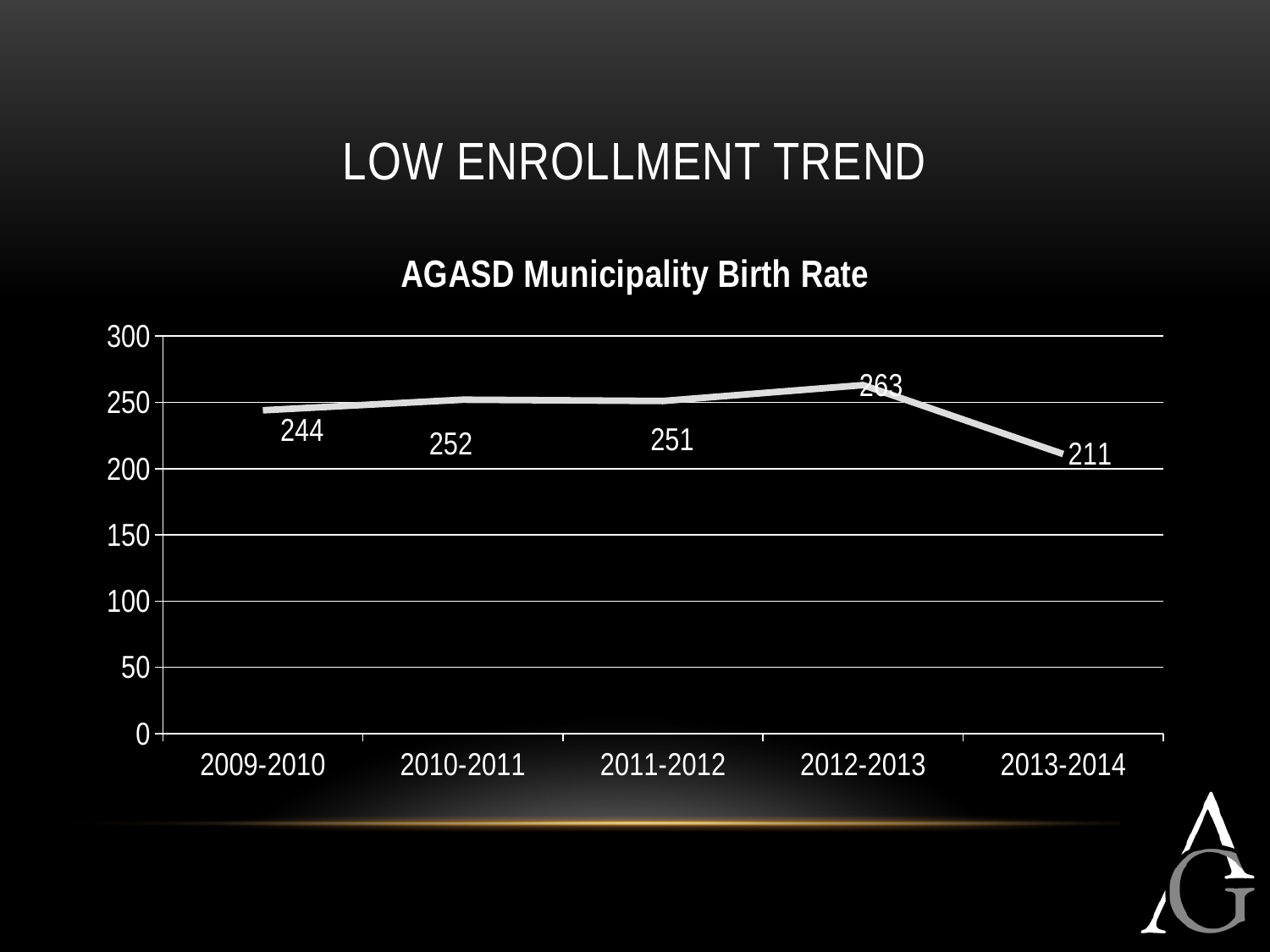
Which is larger, the birth rate in 2010-2011 or in 2011-2012? 2010-2011 What is the birth rate value for 2012-2013? 263 Does the birth rate rise or fall from 2012-2013 to 2013-2014? fall What kind of chart is shown? line chart What is the birth rate value for 2009-2010? 244 What is the difference between the birth rate in 2012-2013 and 2013-2014? 52 Is the birth rate for 2013-2014 greater or less than 250? less What is the title of the chart? AGASD Municipality Birth Rate Which year has the lowest birth rate? 2013-2014 How many years are plotted on the chart? 5 Which year has the highest birth rate? 2012-2013 What is the birth rate value for 2013-2014? 211